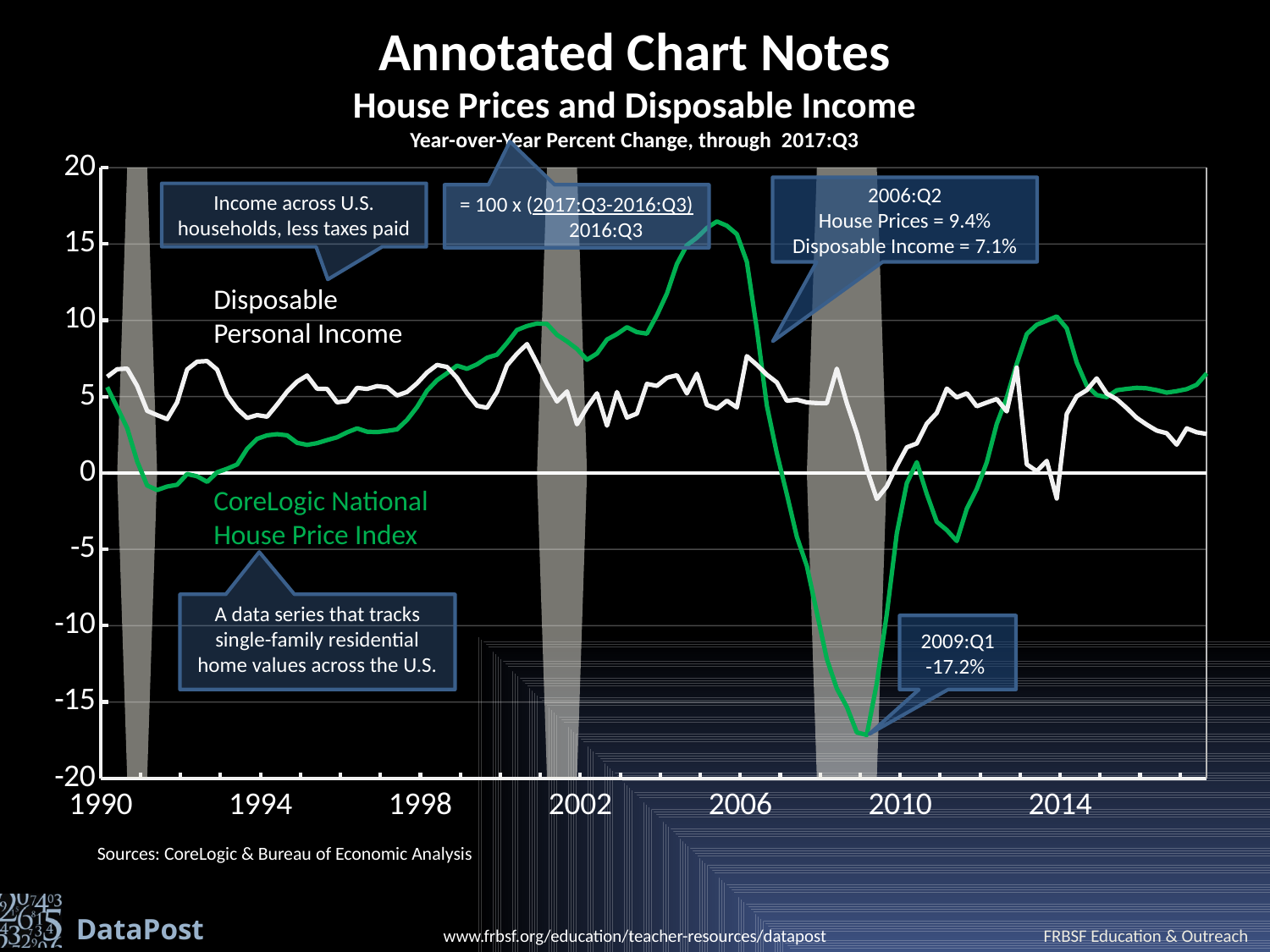
What sources are cited for the chart data? CoreLogic & Bureau of Economic Analysis What value does the annotation give for the CoreLogic National House Price Index in 2009:Q1? -17.2% How many data series are plotted on the chart? 2 Does the CoreLogic National House Price Index rise or fall between 2006 and 2009? fall In 2006:Q2, how many percentage points higher was the House Prices value than the Disposable Income value? 2.3 Is the peak value of the CoreLogic National House Price Index around 2005 greater or less than 15? greater According to the annotation, what was the year-over-year change in House Prices in 2006:Q2? 9.4% What kind of chart is shown on the slide? line chart According to the annotation, what was the year-over-year change in Disposable Income in 2006:Q2? 7.1% What is the title of the chart? House Prices and Disposable Income At which annotated quarter does the CoreLogic National House Price Index reach its lowest point? 2009:Q1 In 2006:Q2, which was larger: House Prices or Disposable Income? House Prices